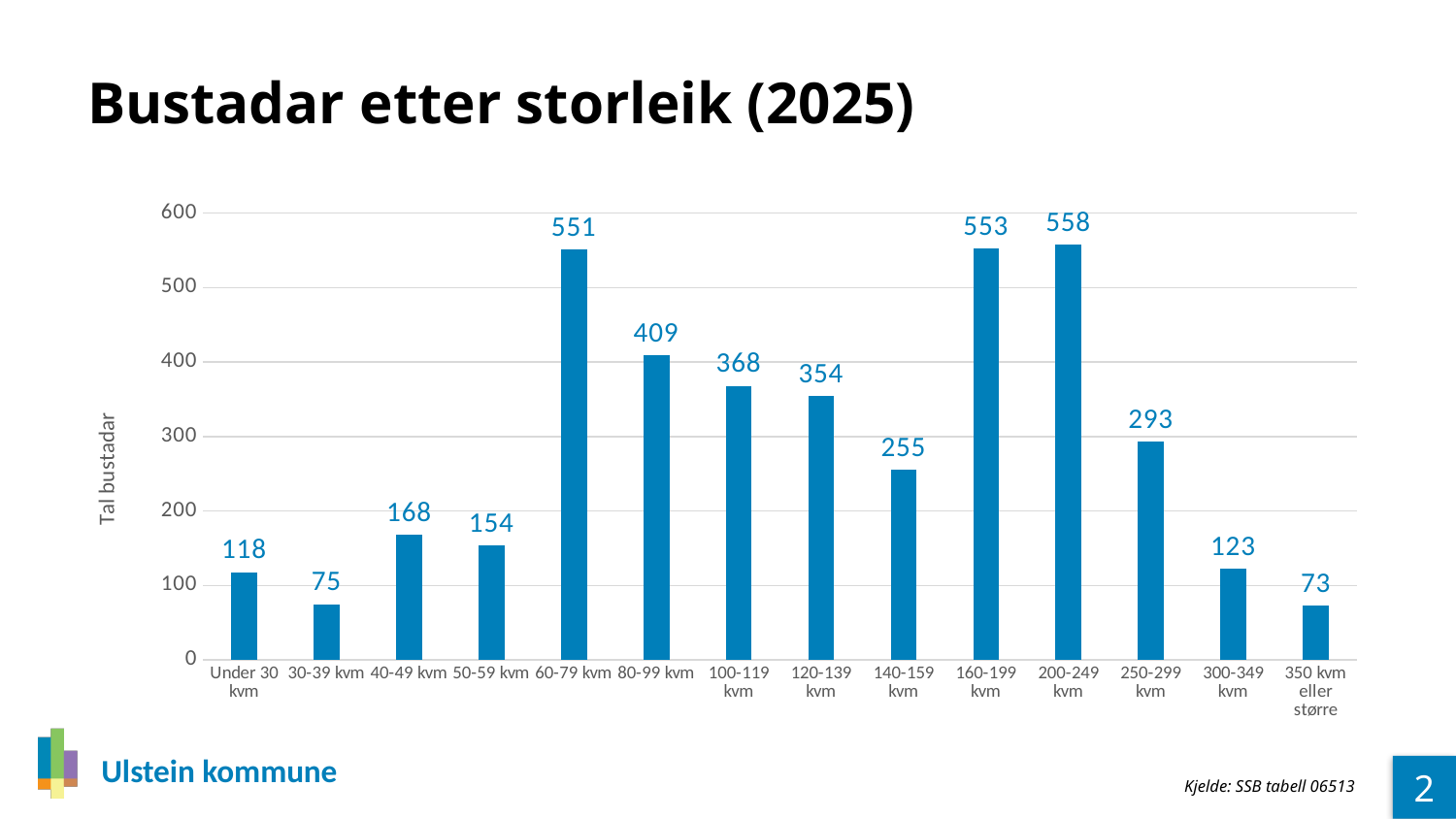
What is the value for 140-159 kvm? 255 How many categories are shown on the x axis? 14 Which category has the lowest value? 350 kvm eller større Which category has the highest value? 200-249 kvm What is the value for 350 kvm eller større? 73 What is the title of the chart? Bustadar etter storleik (2025) Which is larger, the value for 40-49 kvm or the value for 50-59 kvm? 40-49 kvm What kind of chart is shown on the slide? bar chart What is the label of the y axis? Tal bustadar What is the value for 60-79 kvm? 551 What is the difference between the values for 80-99 kvm and 100-119 kvm? 41 Is the value for 250-299 kvm greater or less than 300? less